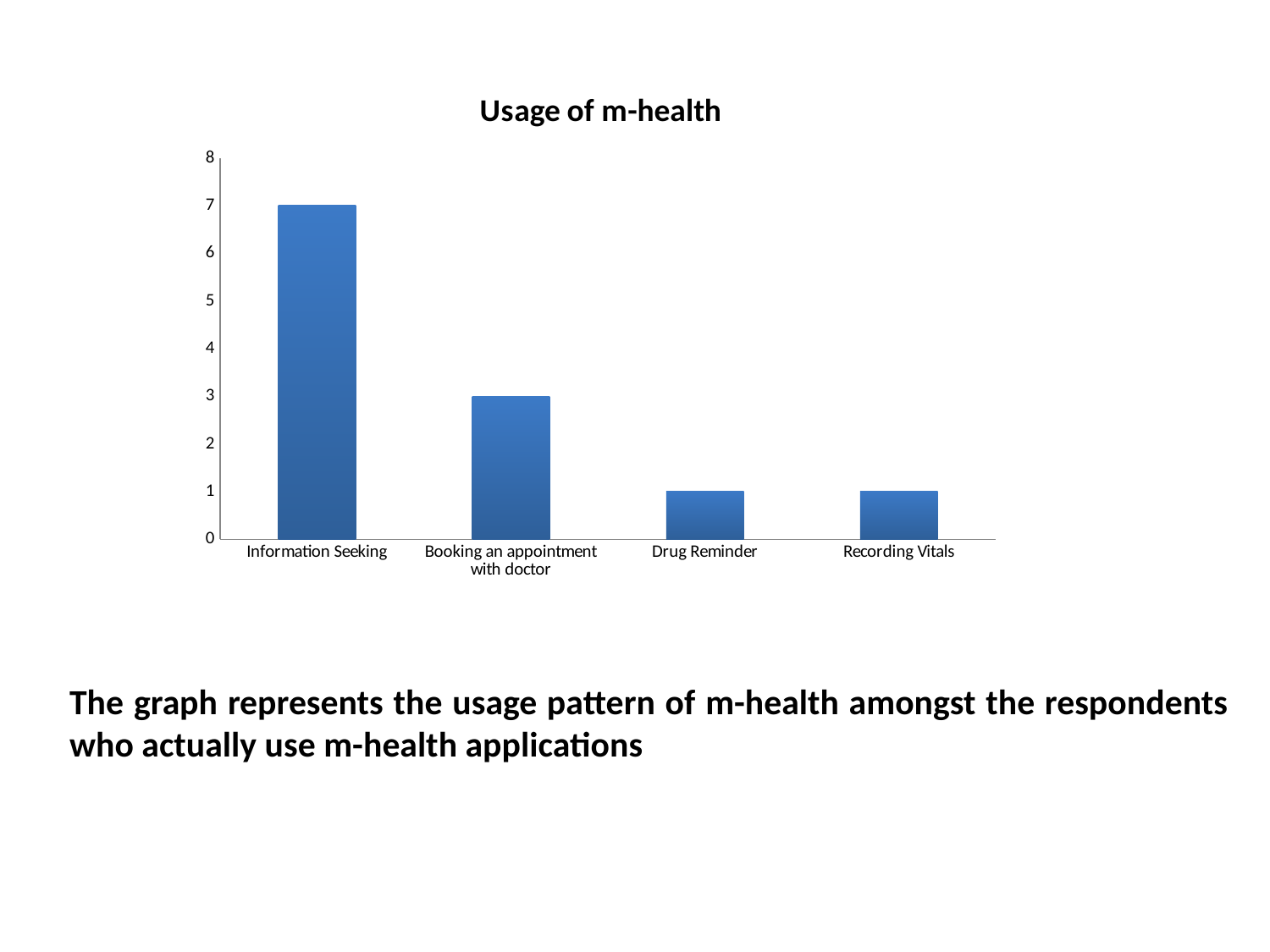
How many categories are shown on the x axis? 4 What is the difference between the values for Information Seeking and Booking an appointment with doctor? 4 What kind of chart is shown on the slide? bar chart Do the values rise or fall from left to right along the x axis? fall What is the value for Drug Reminder? 1 Which is larger, the value for Booking an appointment with doctor or the value for Drug Reminder? Booking an appointment with doctor What is the value for Recording Vitals? 1 What is the value for Information Seeking? 7 Which category has the highest value? Information Seeking What is the title of the chart? Usage of m-health Is the value for Information Seeking greater or less than 5? greater What is the value for Booking an appointment with doctor? 3